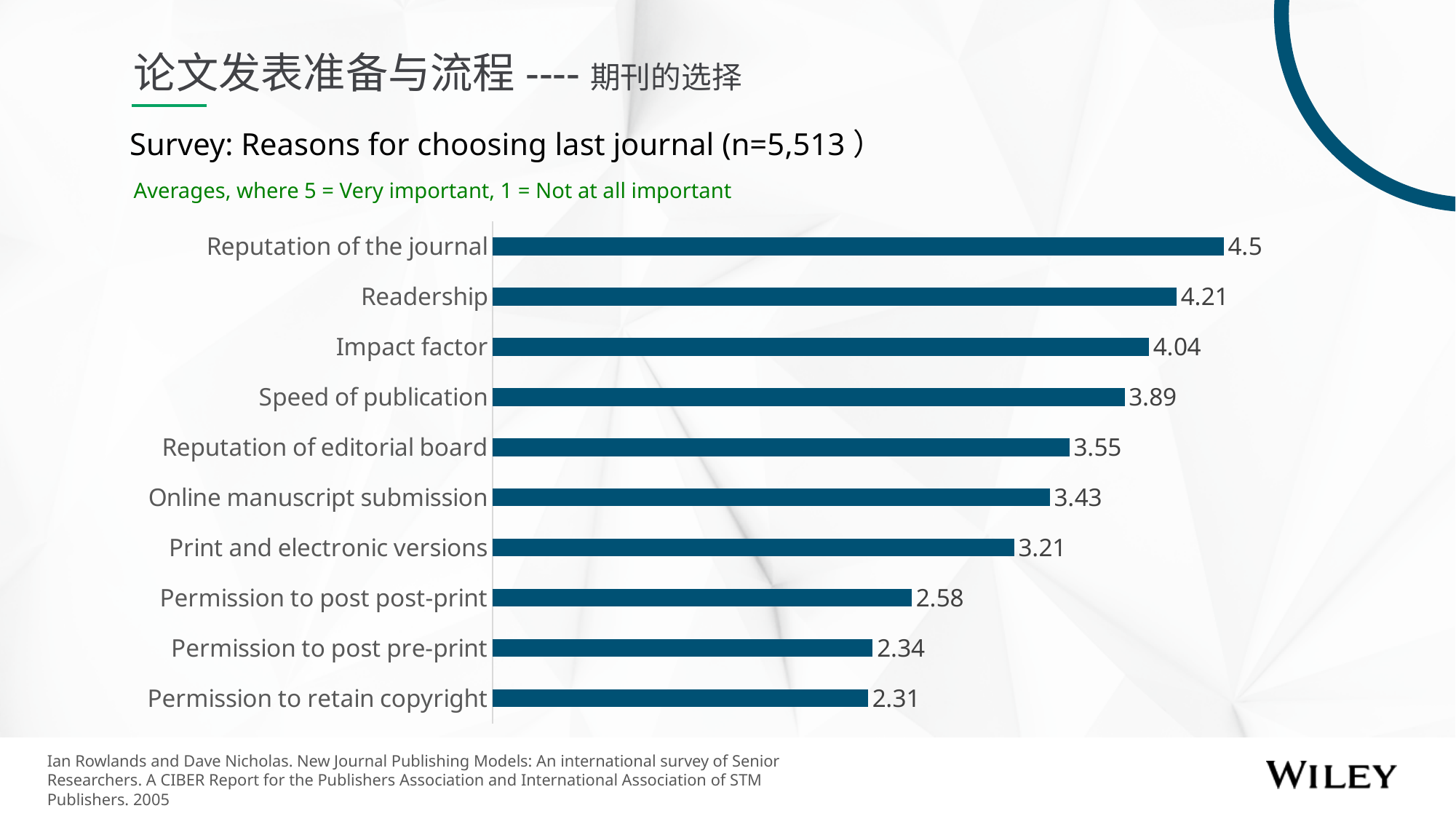
What is the difference between the scores for Speed of publication and Print and electronic versions? 0.68 How many reasons are listed in the chart? 10 Which has a higher score, Reputation of editorial board or Permission to post post-print? Reputation of editorial board What is the average importance score for Impact factor? 4.04 What is the average importance score for Permission to post pre-print? 2.34 Which reason has the highest average score? Reputation of the journal What is the difference between the scores for Reputation of the journal and Readership? 0.29 What is the sample size (n) stated in the chart heading? 5,513 According to the subtitle, what does a score of 5 represent? Very important What is the average importance score for Online manuscript submission? 3.43 What kind of chart is shown on the slide? Bar chart Which reason has the lowest average score? Permission to retain copyright